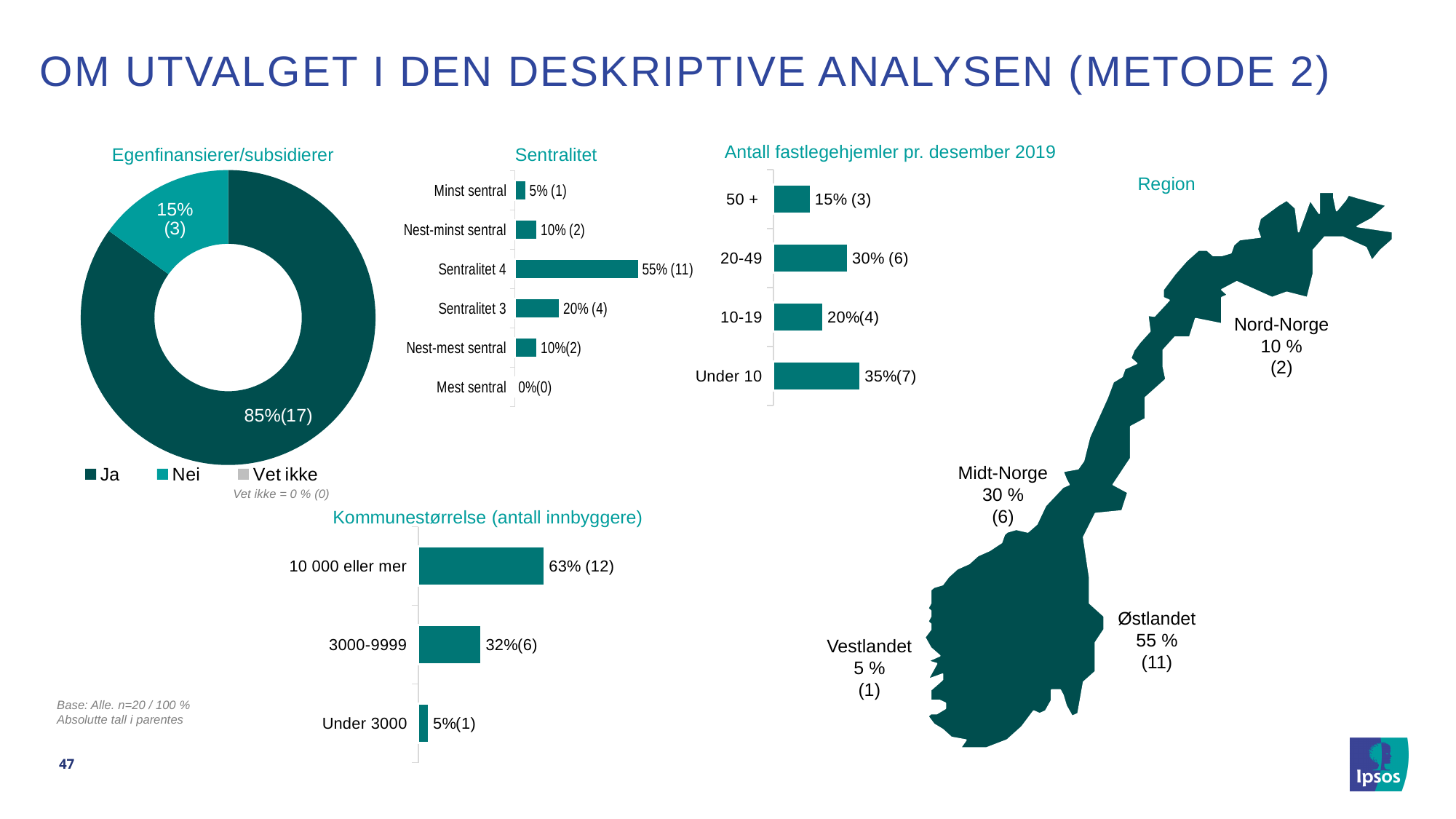
In the 'Kommunestørrelse (antall innbyggere)' chart, what is the value for '3000-9999'? 32%(6) In the 'Antall fastlegehjemler pr. desember 2019' chart, which category has the highest value? Under 10 In the 'Kommunestørrelse (antall innbyggere)' chart, which is larger, '10 000 eller mer' or 'Under 3000'? 10 000 eller mer In the 'Sentralitet' chart, what is the value for 'Sentralitet 4'? 55% (11) In the 'Sentralitet' chart, which category has the lowest value? Mest sentral In the 'Antall fastlegehjemler pr. desember 2019' chart, what is the difference in percentage points between 'Under 10' and '50 +'? 20 percentage points In the 'Egenfinansierer/subsidierer' chart, how many entries does the legend list? 3 In the 'Region' map, what share is shown for Østlandet? 55 % (11) In the 'Egenfinansierer/subsidierer' chart, what kind of chart is used? Donut chart In the 'Antall fastlegehjemler pr. desember 2019' chart, what is the value for '20-49'? 30% (6) In the 'Egenfinansierer/subsidierer' chart, what share is labelled for 'Ja'? 85%(17) In the 'Sentralitet' chart, how many categories are shown? 6